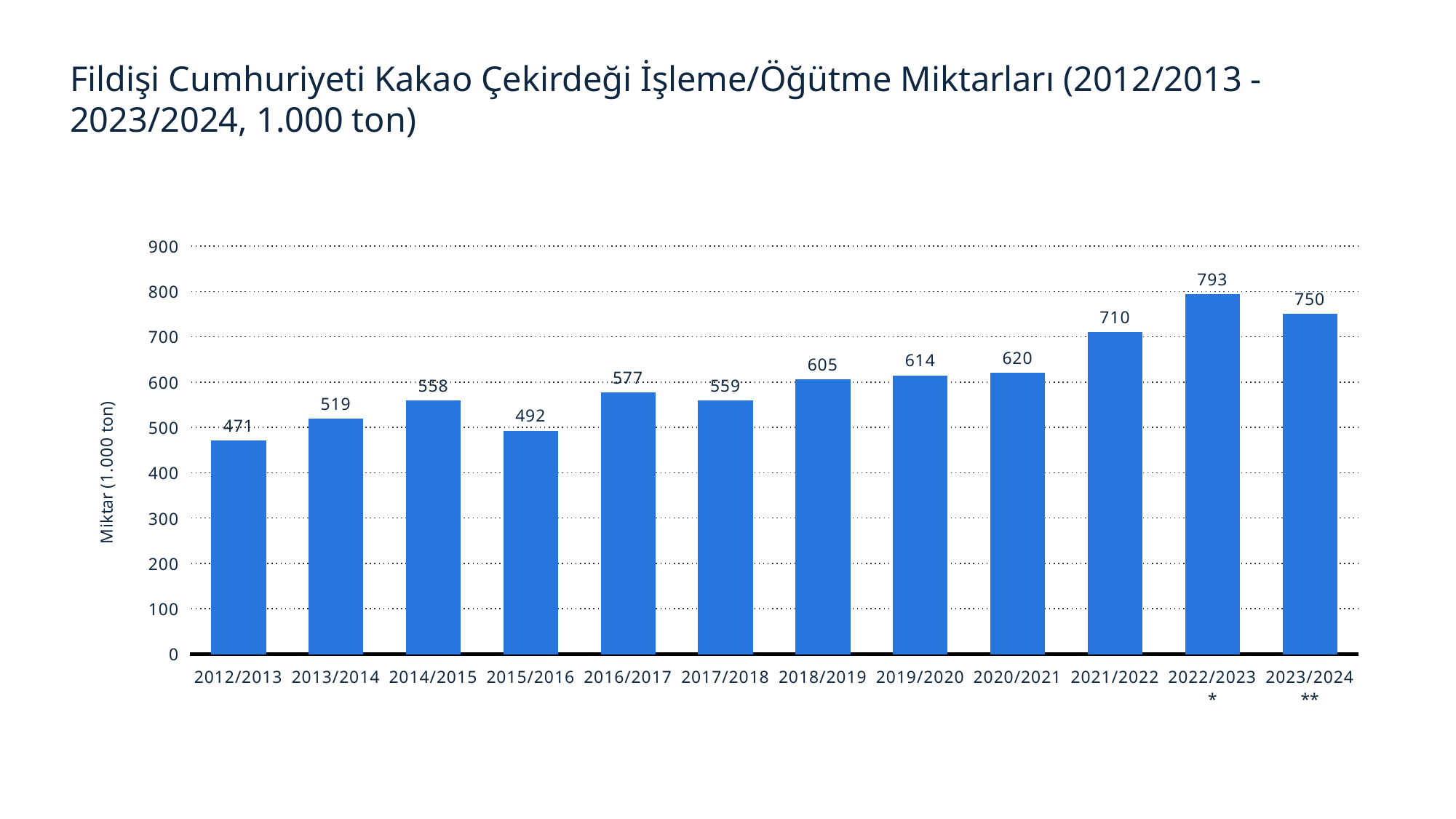
What is the value for 2012/2013? 471 How many seasons are shown on the x axis? 12 What is the value for 2018/2019? 605 Which season has the highest value? 2022/2023* What is the value for 2023/2024**? 750 What kind of chart is shown on the slide? bar chart What is the label of the y axis? Miktar (1.000 ton) What is the difference between the values for 2022/2023* and 2021/2022? 83 Which is larger, the value for 2016/2017 or the value for 2017/2018? 2016/2017 What is the difference between the values for 2015/2016 and 2014/2015? 66 Is the value for 2021/2022 greater or less than 700? greater Which season has the lowest value? 2012/2013